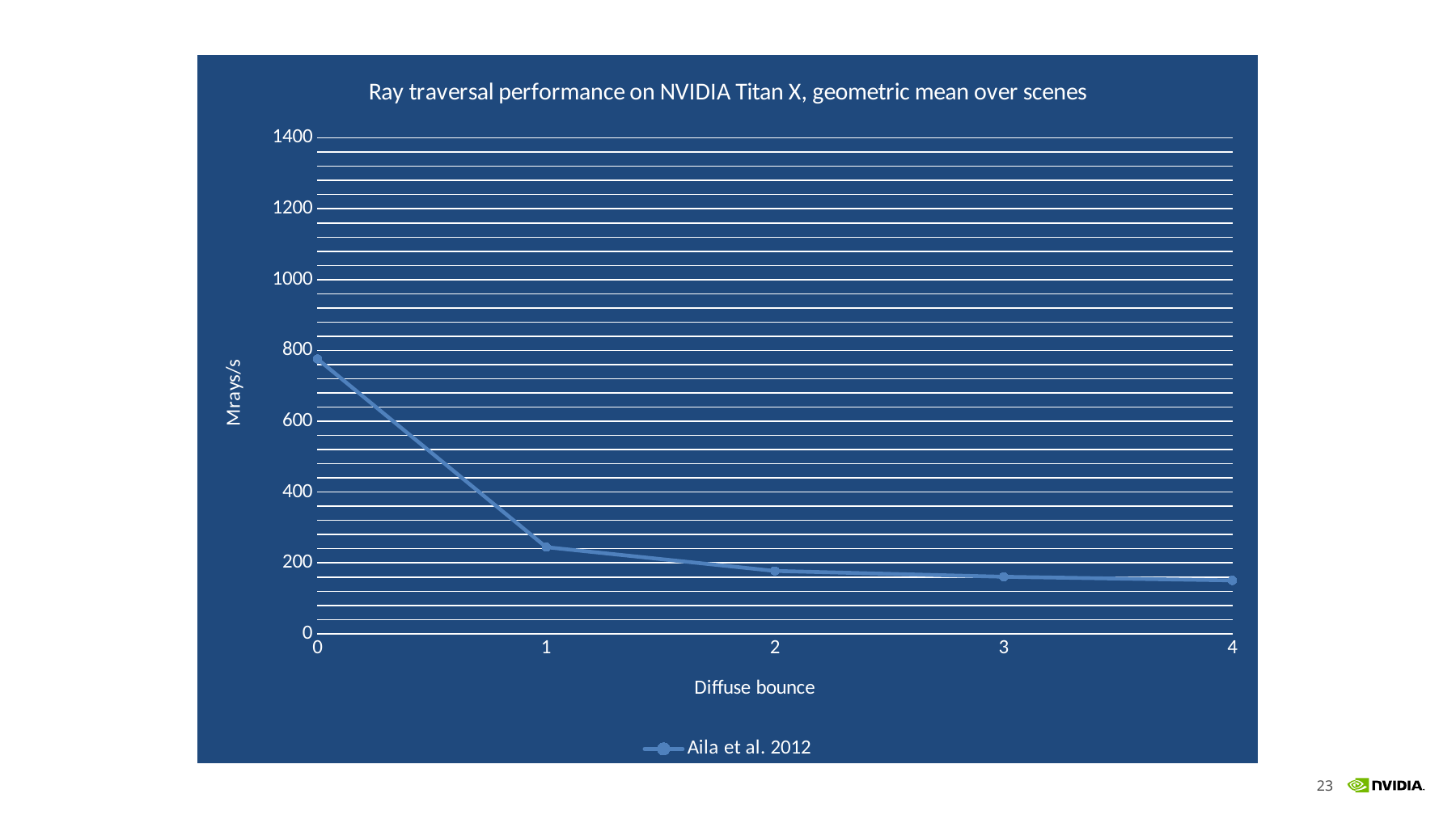
Which has the larger value, diffuse bounce 1 or diffuse bounce 2? diffuse bounce 1 How many data points are plotted on the line? 5 Is the value at diffuse bounce 4 greater or less than 200? less At which diffuse bounce is the Mrays/s value highest? 0 Do the values rise or fall as the diffuse bounce increases from 0 to 4? fall Is the value at diffuse bounce 0 greater or less than 600? greater How many series does the legend list? 1 What is the title of the chart? Ray traversal performance on NVIDIA Titan X, geometric mean over scenes What kind of chart is shown on the slide? line chart What is the name of the series shown in the legend? Aila et al. 2012 Is the value at diffuse bounce 1 greater or less than 400? less Which has the larger value, diffuse bounce 0 or diffuse bounce 3? diffuse bounce 0